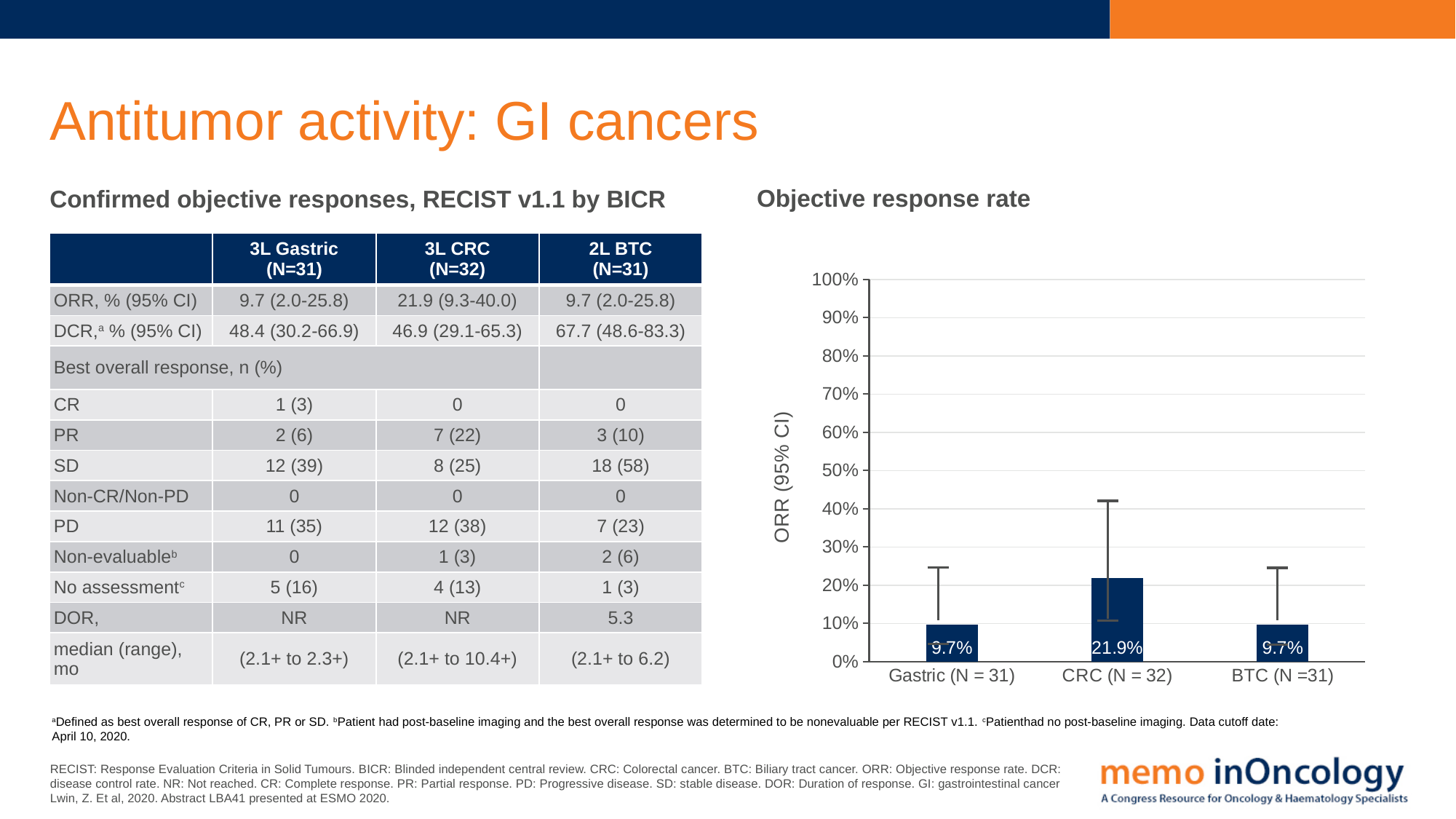
What type of chart is used to show the Objective response rate? bar chart What is the label of the y axis in the Objective response rate chart? ORR (95% CI) Is the ORR for CRC (N = 32) larger or smaller than the ORR for BTC (N =31)? larger Is the ORR value for Gastric (N = 31) greater or less than 10%? less What is the ORR value shown for Gastric (N = 31) in the Objective response rate chart? 9.7% What is the ORR value shown for BTC (N =31) in the Objective response rate chart? 9.7% Is the ORR value for CRC (N = 32) greater or less than 20%? greater Which category has the highest ORR in the Objective response rate chart? CRC (N = 32) What is the maximum value shown on the y axis of the Objective response rate chart? 100% What is the ORR value shown for CRC (N = 32) in the Objective response rate chart? 21.9% What is the difference between the ORR for CRC (N = 32) and the ORR for Gastric (N = 31)? 12.2% How many categories are plotted in the Objective response rate chart? 3